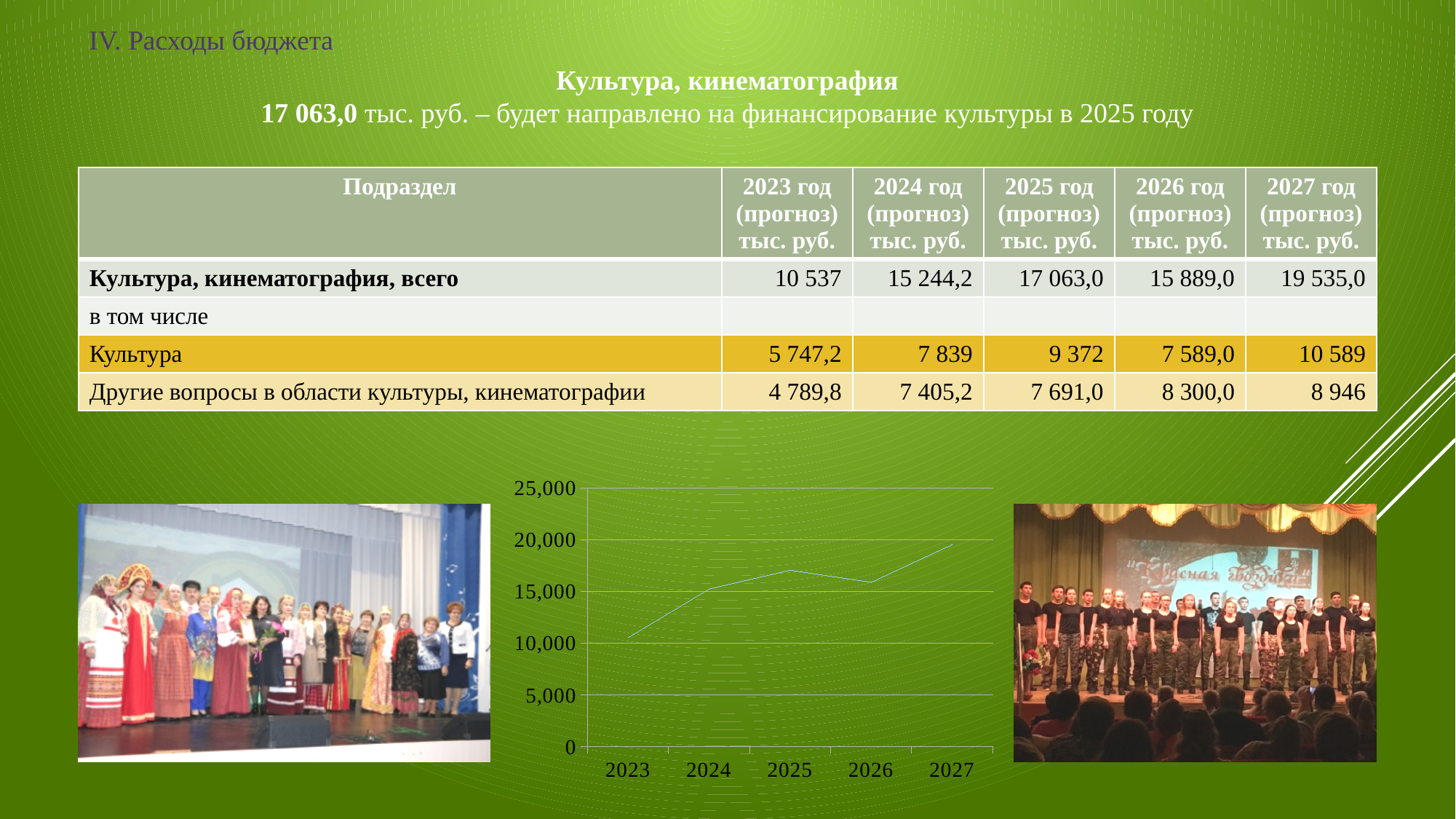
Which year has the lowest value on the line chart? 2023 Is the value for 2023 on the line chart greater or less than 10,000? greater Which year has the highest value on the line chart? 2027 Is the value for 2025 on the line chart greater or less than 15,000? greater On the line chart, which year has the larger value, 2025 or 2026? 2025 What kind of chart is shown on the slide? line chart On the line chart, which year has the larger value, 2023 or 2027? 2027 How many years are plotted along the x axis of the line chart? 5 Is the value for 2024 on the line chart greater or less than 20,000? less Does the line on the chart generally rise or fall from 2023 to 2027? rise